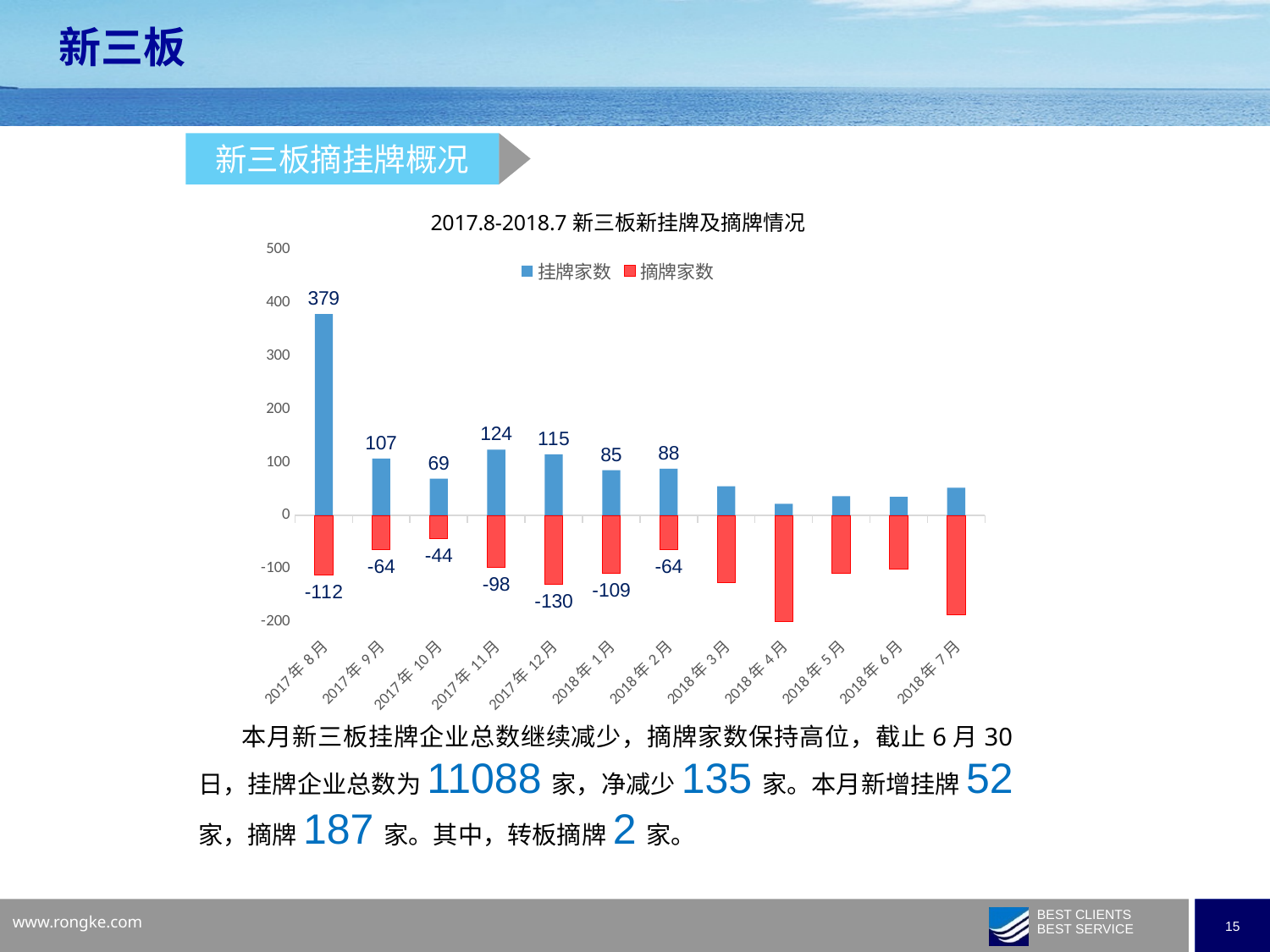
How many series does the chart's legend list? 2 Which month has the lowest 挂牌家数? 2018年4月 Is the 挂牌家数 value for 2018年3月 greater or less than 100? less What is the 摘牌家数 value for 2017年10月? -44 How many months are shown on the x axis of the chart? 12 What is the difference between the 挂牌家数 values for 2017年11月 and 2017年12月? 9 Which month has the larger 挂牌家数, 2017年9月 or 2017年10月? 2017年9月 What kind of chart is shown on the slide? bar chart What is the 摘牌家数 value for 2017年12月? -130 What is the title of the chart? 2017.8-2018.7 新三板新挂牌及摘牌情况 Which month has the highest 挂牌家数? 2017年8月 What is the 挂牌家数 value for 2017年8月? 379